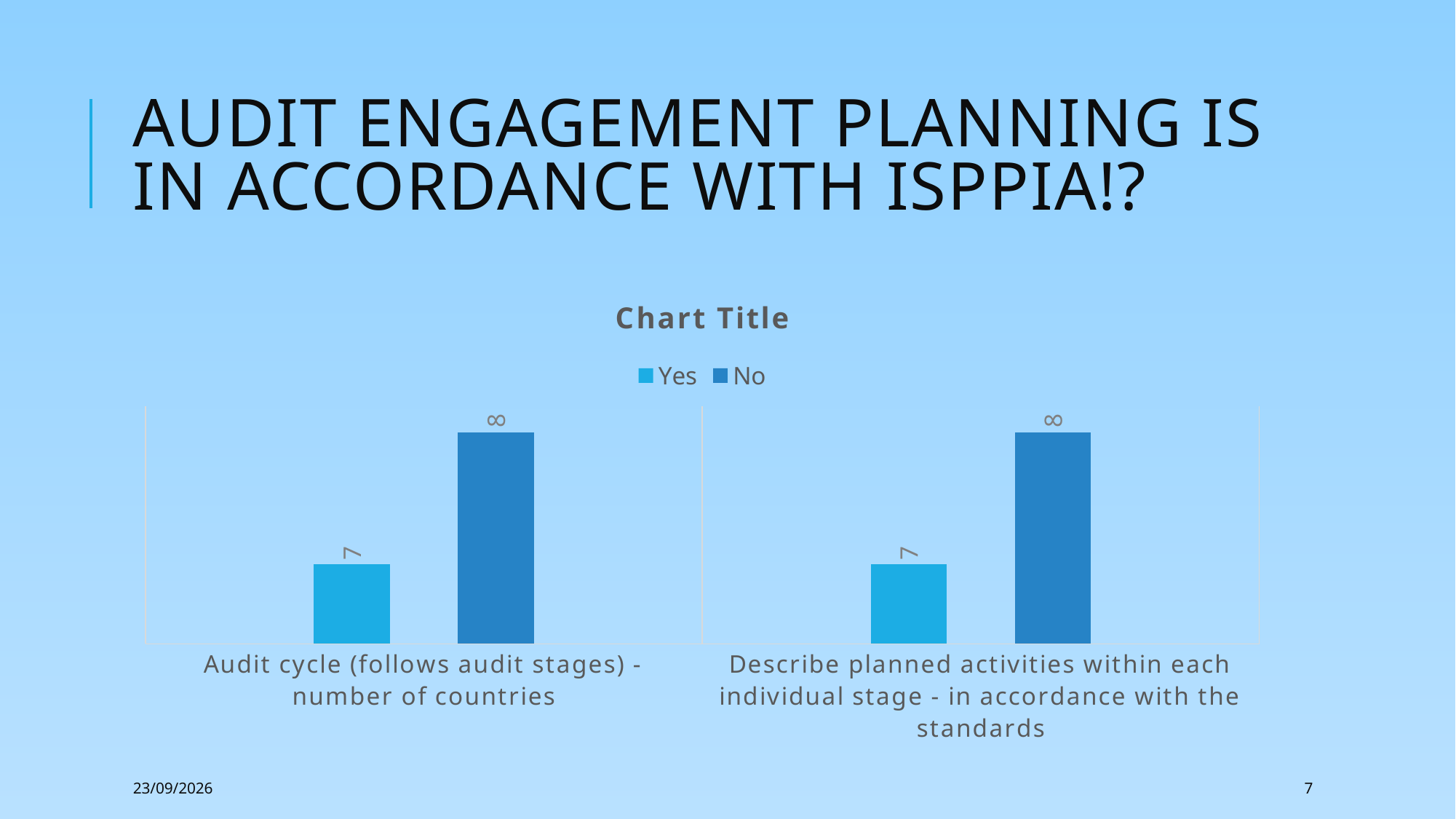
What are the two entries in the chart legend? Yes, No What kind of chart is shown on the slide? bar chart What is the value for Yes in the category "Describe planned activities within each individual stage - in accordance with the standards"? 7 How many categories are shown on the x axis? 2 How many series does the legend list? 2 What is the value for No in the category "Audit cycle (follows audit stages) - number of countries"? 8 What is the value for No in the category "Describe planned activities within each individual stage - in accordance with the standards"? 8 What is the title of the chart? Chart Title What is the total of the Yes and No values for the category "Audit cycle (follows audit stages) - number of countries"? 15 What is the value for Yes in the category "Audit cycle (follows audit stages) - number of countries"? 7 What is the difference between the No and Yes values in the category "Describe planned activities within each individual stage - in accordance with the standards"? 1 In the category "Audit cycle (follows audit stages) - number of countries", which series has the larger value, Yes or No? No